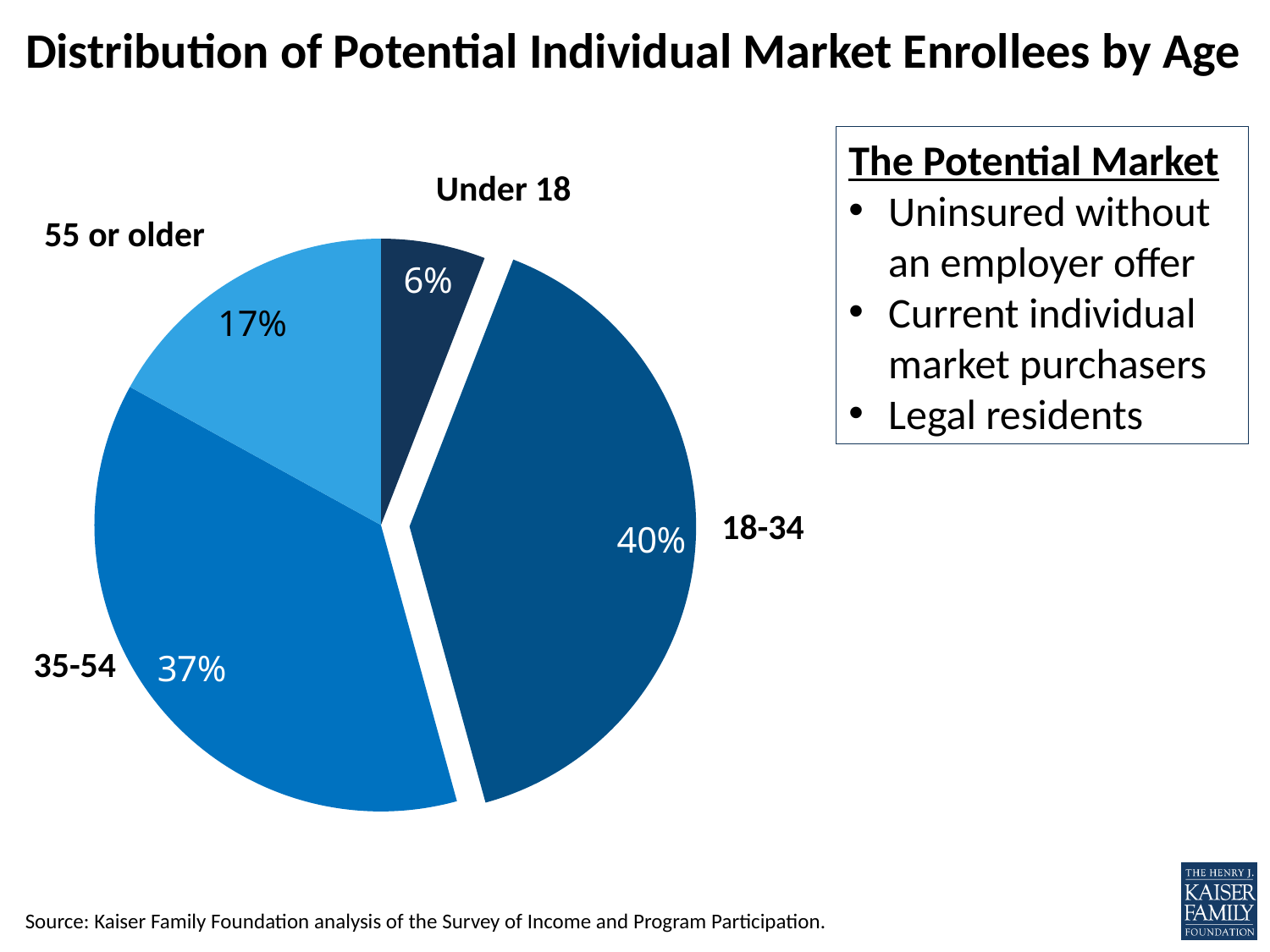
What share of potential individual market enrollees are 55 or older? 17% What share of potential individual market enrollees are under 18? 6% How many age groups are shown in the pie chart? 4 What share of potential individual market enrollees are aged 18-34? 40% What kind of chart is shown on the slide? Pie chart What is the difference in percentage points between the 18-34 share and the 55 or older share? 23 percentage points What is the title of the chart? Distribution of Potential Individual Market Enrollees by Age Which age group makes up the largest share of potential individual market enrollees? 18-34 Which age group makes up the smallest share of potential individual market enrollees? Under 18 Which slice of the pie is pulled out (exploded) from the rest? 18-34 Which is larger, the share for 35-54 or the share for 55 or older? 35-54 What share of potential individual market enrollees are aged 35-54? 37%